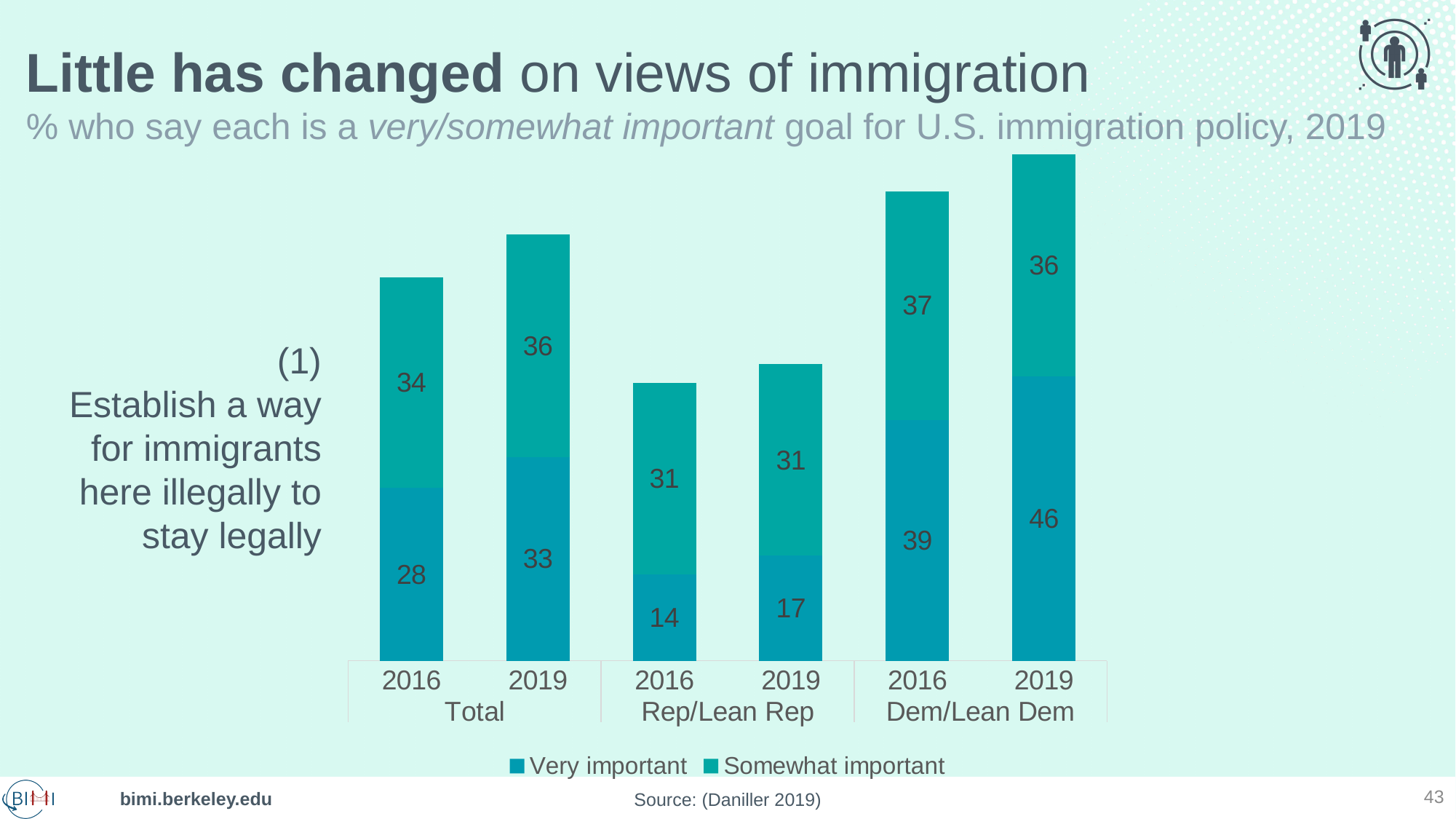
What is the total of the stacked bar for Rep/Lean Rep in 2016? 45 What is the difference between the 'Very important' values for Dem/Lean Dem in 2019 and 2016? 7 Which bar has the highest 'Very important' value? Dem/Lean Dem 2019 Which is larger: the 'Very important' value for Total in 2019 or for Rep/Lean Rep in 2019? Total 2019 What is the 'Very important' value for Rep/Lean Rep in 2019? 17 How many bars are plotted in the chart? 6 What is the 'Somewhat important' value for Dem/Lean Dem in 2016? 37 What is the total of the stacked bar for Dem/Lean Dem in 2019? 82 How many series does the legend list? 2 What kind of chart is shown on the slide? Stacked bar chart What is the 'Very important' value for Total in 2016? 28 Which bar has the lowest 'Very important' value? Rep/Lean Rep 2016